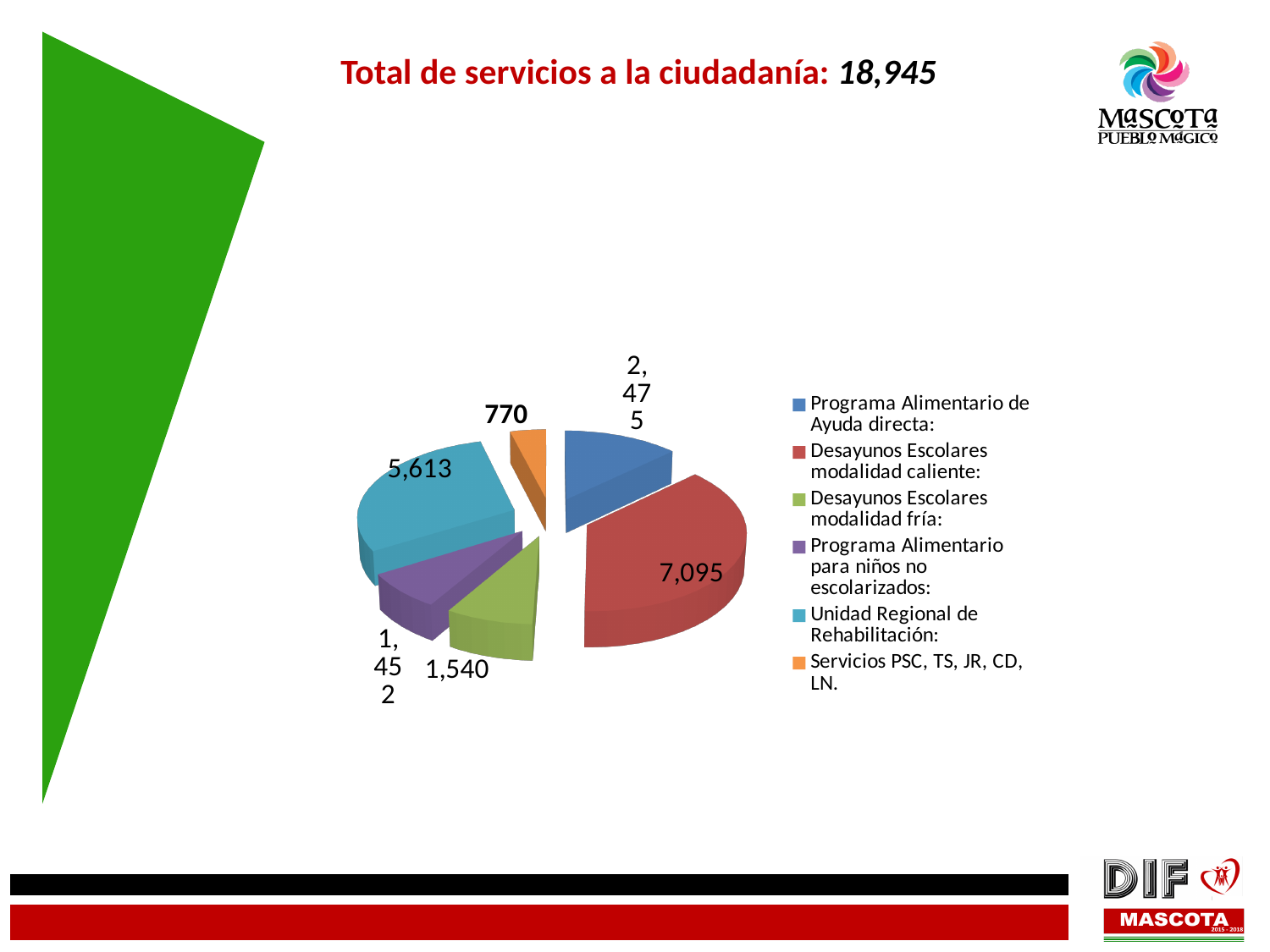
What is the difference between Desayunos Escolares modalidad caliente and Unidad Regional de Rehabilitación? 1,482 What total number of services is stated in the slide title? 18,945 What is the value for Programa Alimentario de Ayuda directa? 2,475 How many slices does the pie chart have? 6 How many entries does the legend list? 6 What is the value for Desayunos Escolares modalidad caliente? 7,095 Which is larger, Unidad Regional de Rehabilitación or Programa Alimentario de Ayuda directa? Unidad Regional de Rehabilitación Which category has the largest slice of the pie? Desayunos Escolares modalidad caliente What kind of chart is shown on the slide? Pie chart What is the value for Servicios PSC, TS, JR, CD, LN.? 770 Which category has the smallest slice of the pie? Servicios PSC, TS, JR, CD, LN. What is the value for Unidad Regional de Rehabilitación? 5,613